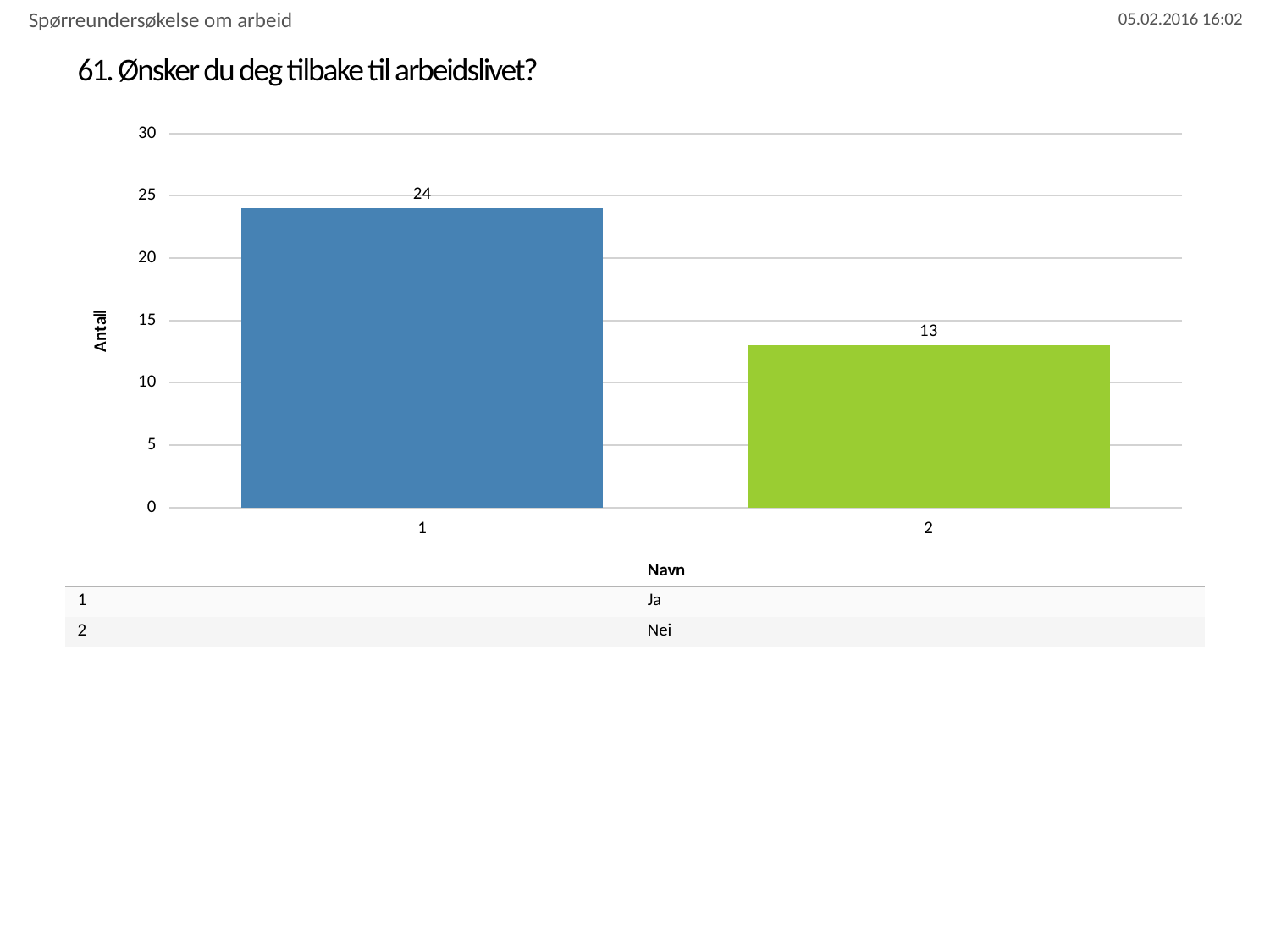
What is the value for category 1 (Ja)? 24 Which is larger, the value for Ja or the value for Nei? Ja What is the title of the chart? 61. Ønsker du deg tilbake til arbeidslivet? What is the difference between the values for category 1 and category 2? 11 What is the value for category 2 (Nei)? 13 Which category has the highest value? 1 (Ja) What is the label of the y axis? Antall How many categories are shown in the chart? 2 Is the value for category 1 greater or less than 20? greater What kind of chart is shown on the slide? bar chart Is the value for category 2 greater or less than 15? less Which category has the lowest value? 2 (Nei)